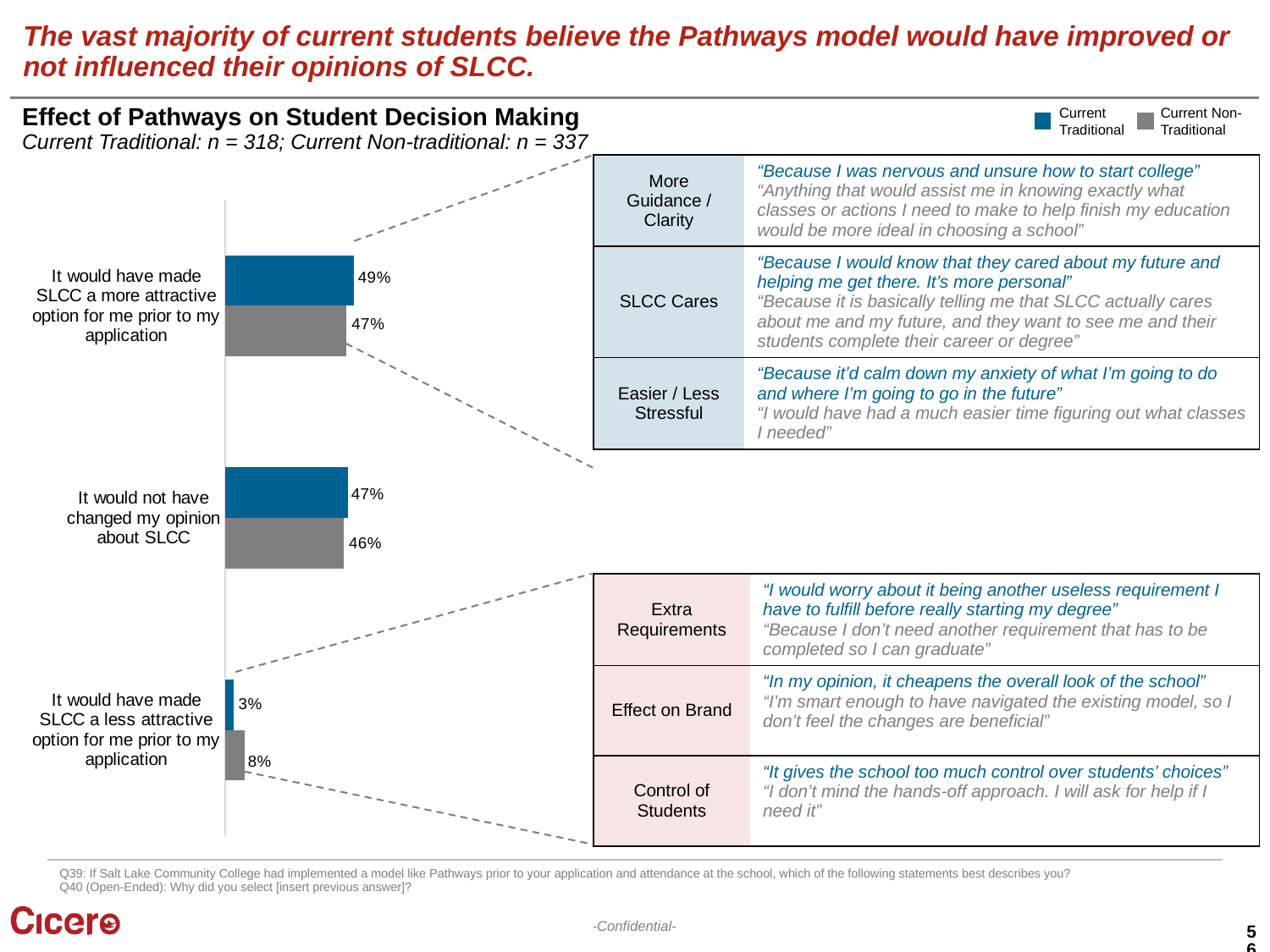
What is the title of the chart? Effect of Pathways on Student Decision Making What is the Current Non-Traditional value for "It would have made SLCC a more attractive option for me prior to my application"? 47% What kind of chart is shown on the slide? bar chart Which category has the lowest Current Traditional value? It would have made SLCC a less attractive option for me prior to my application What is the Current Non-Traditional value for "It would have made SLCC a less attractive option for me prior to my application"? 8% For "It would have made SLCC a less attractive option for me prior to my application", which series has the larger value, Current Traditional or Current Non-Traditional? Current Non-Traditional What is the difference between the Current Non-Traditional and Current Traditional values for "It would have made SLCC a less attractive option for me prior to my application"? 5% How many categories are plotted in the chart? 3 What is the Current Traditional value for "It would not have changed my opinion about SLCC"? 47% What is the Current Traditional value for "It would have made SLCC a more attractive option for me prior to my application"? 49% How many series does the legend list? 2 Which category has the highest Current Traditional value? It would have made SLCC a more attractive option for me prior to my application